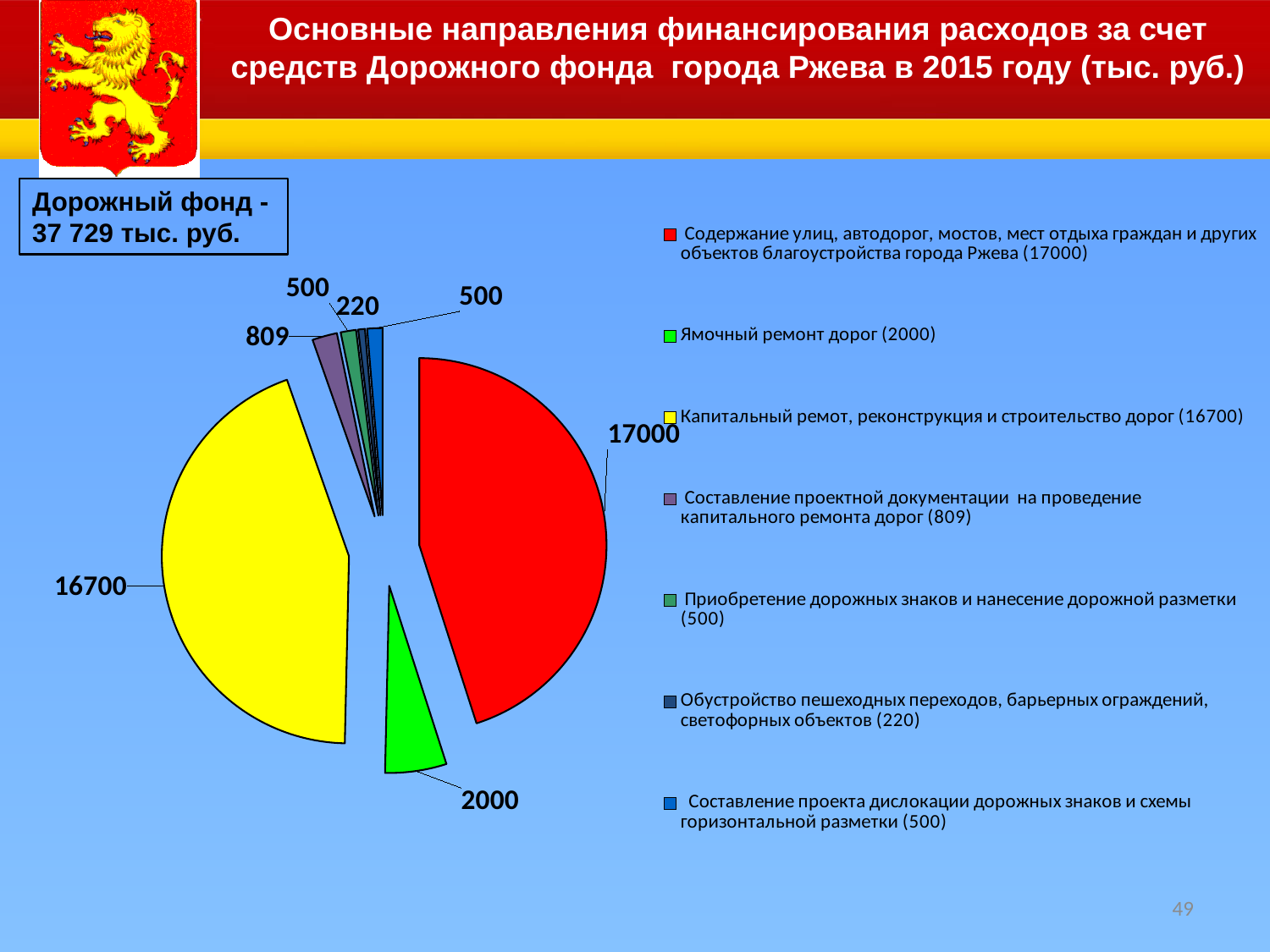
What is the value for "Капитальный ремот, реконструкция и строительство дорог"? 16700 How many entries does the legend list? 7 Which category has the smallest slice of the pie? Обустройство пешеходных переходов, барьерных ограждений, светофорных объектов What is the value for "Составление проектной документации на проведение капитального ремонта дорог"? 809 What colour is the slice for "Ямочный ремонт дорог"? green What is the value for "Обустройство пешеходных переходов, барьерных ограждений, светофорных объектов"? 220 What is the value for "Ямочный ремонт дорог"? 2000 What is the difference between the value for "Содержание улиц, автодорог, мостов..." (17000) and the value for "Капитальный ремот, реконструкция и строительство дорог" (16700)? 300 How many slices does the pie chart have? 7 Which is larger: the value for "Ямочный ремонт дорог" or the value for "Составление проектной документации на проведение капитального ремонта дорог"? Ямочный ремонт дорог What kind of chart is shown on the slide? pie chart Which category has the largest slice of the pie? Содержание улиц, автодорог, мостов, мест отдыха граждан и других объектов благоустройства города Ржева